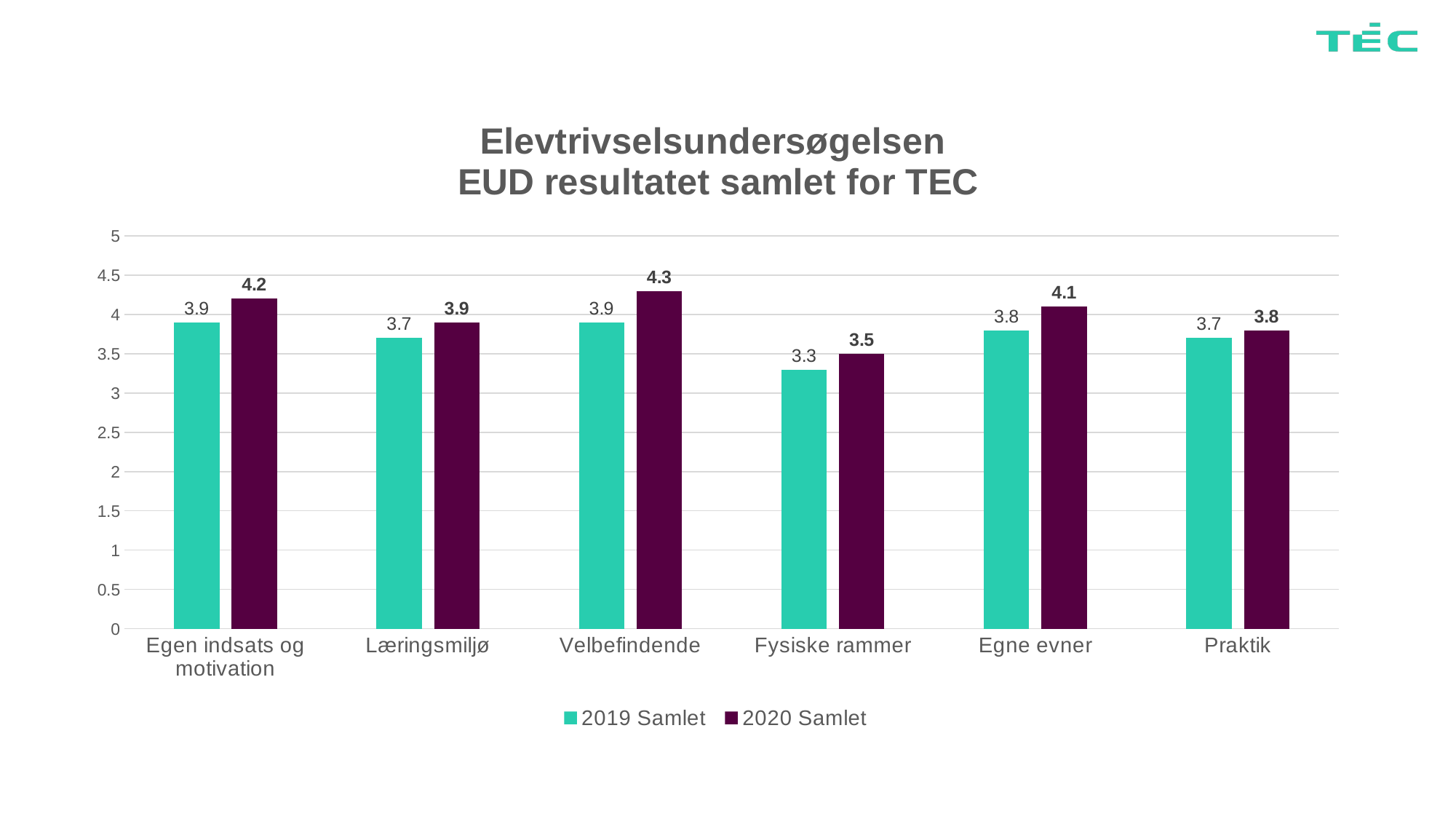
What is the 2020 Samlet value for Egen indsats og motivation? 4.2 How many categories are shown on the x axis? 6 Which category has the lowest 2019 Samlet value? Fysiske rammer What kind of chart is shown on the slide? Bar chart Which series is shown in dark purple? 2020 Samlet What is the 2019 Samlet value for Fysiske rammer? 3.3 How many series does the legend list? 2 What is the 2020 Samlet value for Velbefindende? 4.3 Which is larger for Egne evner: the 2019 Samlet value or the 2020 Samlet value? 2020 Samlet Which category has the highest 2020 Samlet value? Velbefindende What is the difference between the 2020 Samlet and 2019 Samlet values for Velbefindende? 0.4 Is the 2019 Samlet value for Fysiske rammer greater or less than 3.5? less